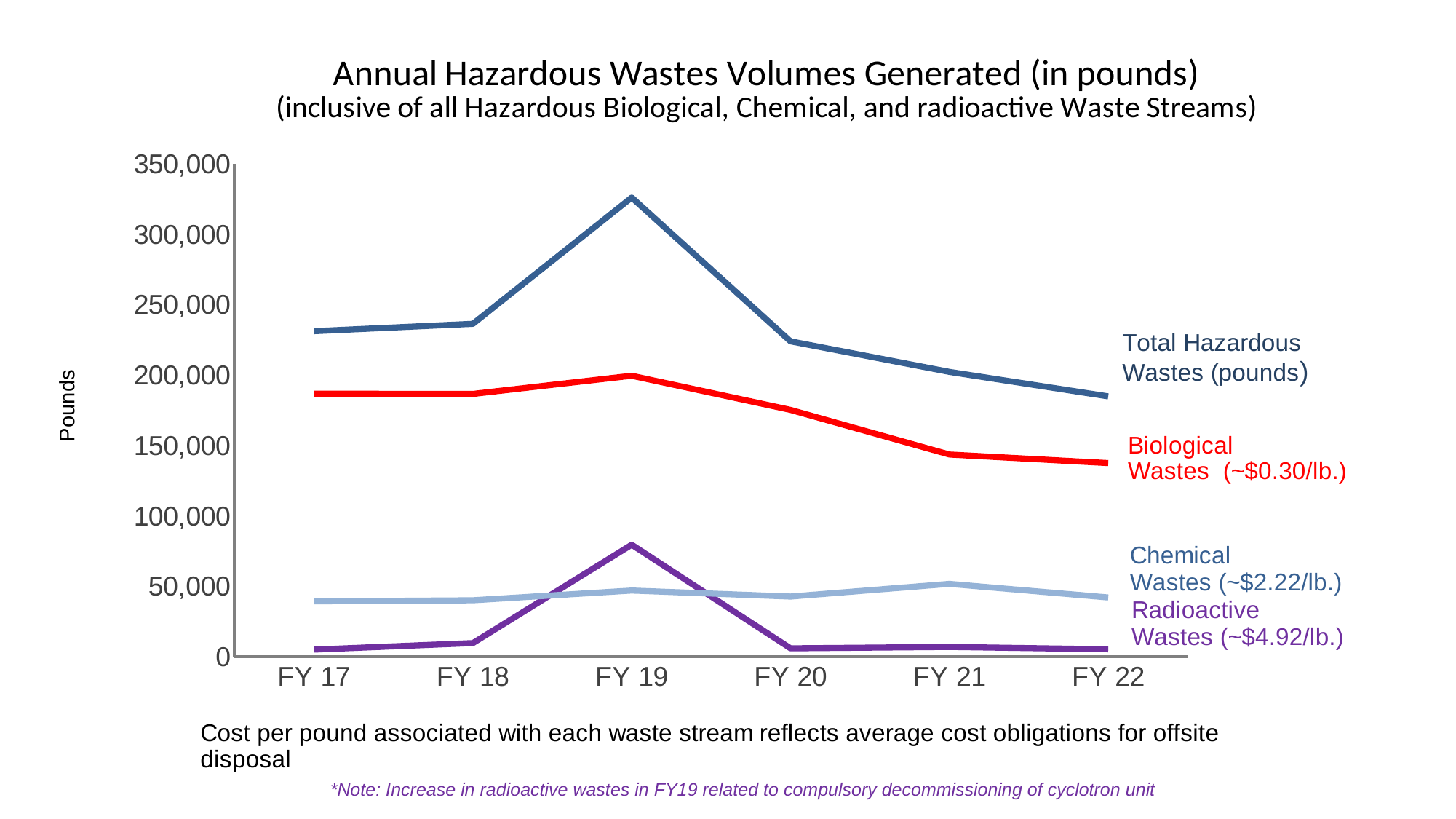
Is the value for Radioactive Wastes in FY 19 greater or less than 50,000? greater Is the value for Total Hazardous Wastes in FY 19 greater or less than 300,000? greater In which fiscal year do Radioactive Wastes peak? FY 19 Is the value for Biological Wastes in FY 22 greater or less than 150,000? less In which fiscal year is Total Hazardous Wastes at its highest? FY 19 How many waste series are plotted on the chart? 4 Do Biological Wastes rise or fall from FY 19 to FY 22? Fall In FY 19, which is larger: Chemical Wastes or Radioactive Wastes? Radioactive Wastes In which fiscal year is Total Hazardous Wastes at its lowest? FY 22 What kind of chart is shown on the slide? Line chart How many fiscal years are plotted along the x axis? 6 What approximate cost per pound is listed for Chemical Wastes? ~$2.22/lb.